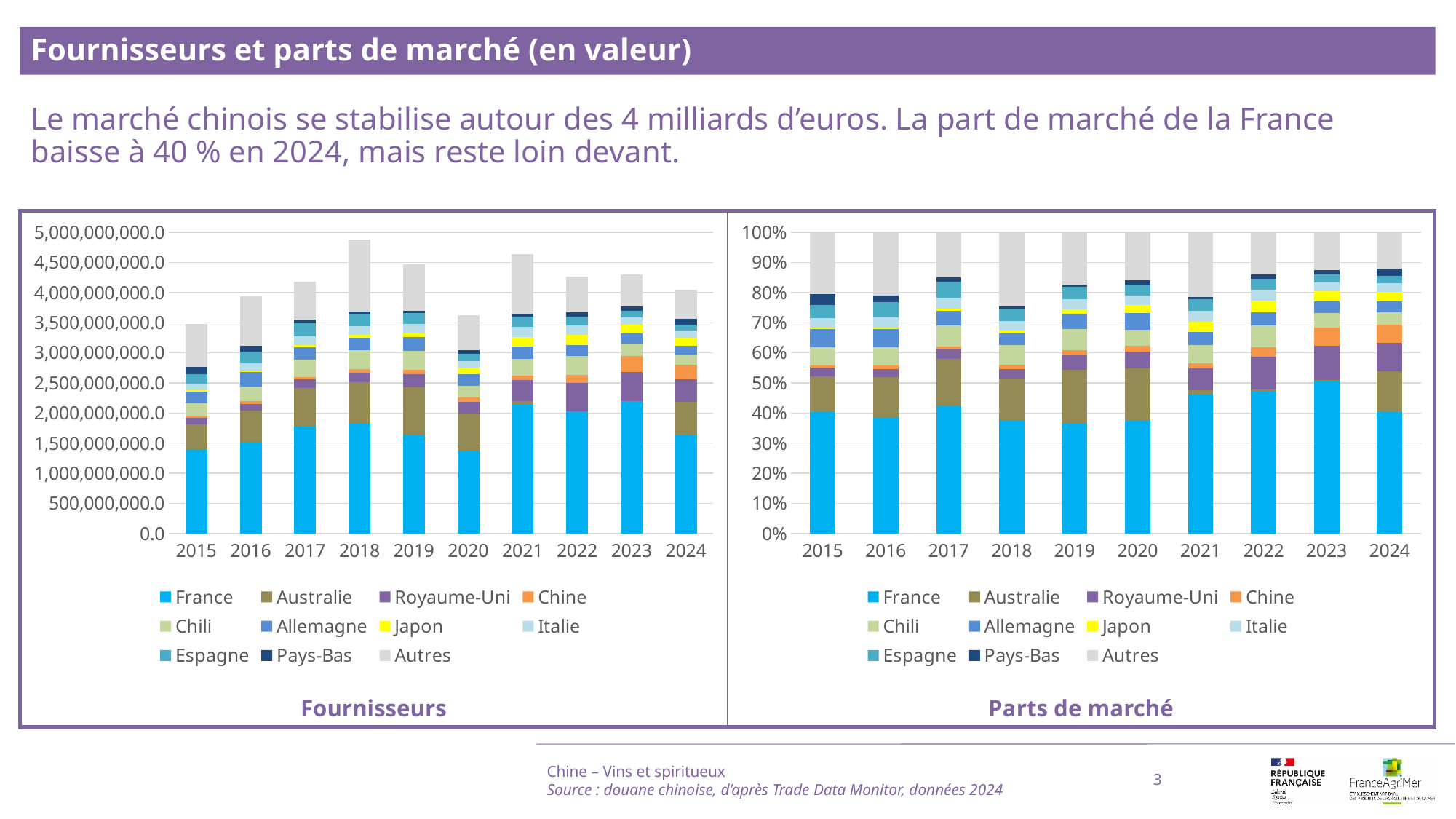
Which series is shown in light grey at the top of each bar in both charts? Autres In the 'Fournisseurs' chart, which year has the lowest total bar? 2015 In the 'Fournisseurs' chart, is the France value for 2023 greater or less than 2,000,000,000.0? greater How many years are shown on the x axis of the 'Fournisseurs' chart? 10 In the 'Fournisseurs' chart, which year has the highest total bar? 2018 What kind of chart is the 'Fournisseurs' chart on the left? Stacked bar chart In the 'Fournisseurs' chart, is the total for 2018 greater or less than 4,500,000,000.0? greater In the 'Parts de marché' chart, is the France share for 2021 greater or less than 40%? greater How many series does the legend of the 'Parts de marché' chart list? 11 In the 'Fournisseurs' chart, is the total bar for 2021 larger or smaller than the total bar for 2022? larger In the 'Parts de marché' chart, which year has the largest France share? 2023